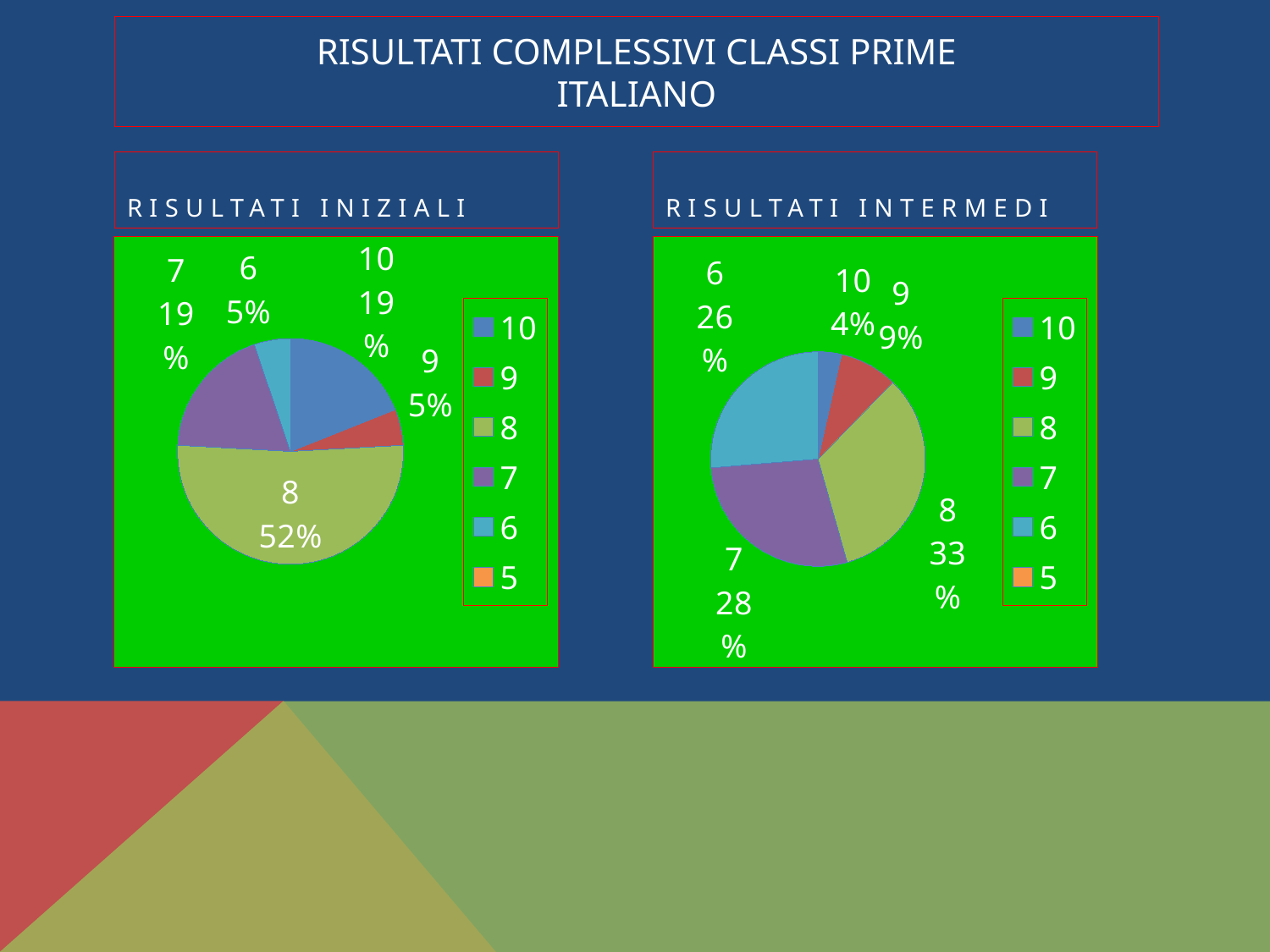
In the RISULTATI INIZIALI chart, what share of the pie does category 8 have? 52% In the RISULTATI INTERMEDI chart, which category has the smallest slice? 10 In the RISULTATI INTERMEDI chart, what is the difference in percentage points between category 8 and category 6? 7 What type of chart is the RISULTATI INTERMEDI chart? Pie chart In the RISULTATI INTERMEDI chart, which category has the largest slice? 8 How many entries does the legend of the RISULTATI INIZIALI chart list? 6 In the RISULTATI INIZIALI chart, which category has the largest slice? 8 In the RISULTATI INTERMEDI chart, what percentage is shown for category 10? 4% In the RISULTATI INTERMEDI chart, what percentage is shown for category 7? 28% In the RISULTATI INTERMEDI chart, which is larger, the slice for category 6 or the slice for category 9? 6 In the RISULTATI INIZIALI chart, what percentage is shown for category 10? 19% In the RISULTATI INIZIALI chart, what is the difference in percentage points between category 8 and category 7? 33